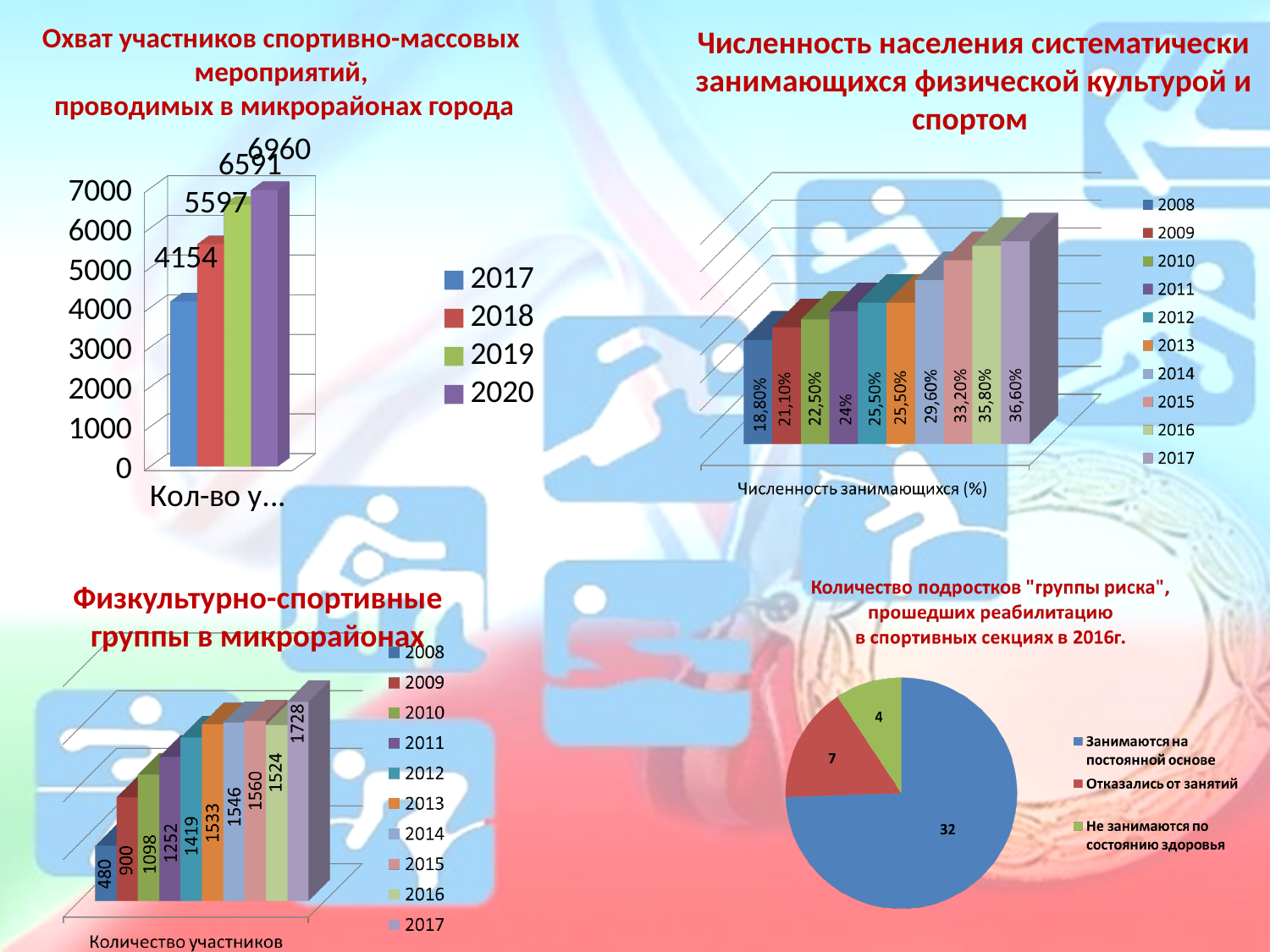
In the chart titled "Охват участников спортивно-массовых мероприятий, проводимых в микрорайонах города", how many series does the legend list? 4 In the chart titled "Охват участников спортивно-массовых мероприятий, проводимых в микрорайонах города", what is the value for 2018? 5597 In the chart titled "Охват участников спортивно-массовых мероприятий, проводимых в микрорайонах города", which year has the highest value? 2020 In the chart titled "Охват участников спортивно-массовых мероприятий, проводимых в микрорайонах города", what is the difference between the 2020 and 2017 values? 2806 In the chart titled "Численность населения систематически занимающихся физической культурой и спортом", which year has the lowest value? 2008 In the chart titled "Физкультурно-спортивные группы в микрорайонах", what is the difference between the 2017 and 2008 values? 1248 In the pie chart about подростков "группы риска", what is the value for "Отказались от занятий"? 7 In the chart titled "Численность населения систематически занимающихся физической культурой и спортом", do the values rise or fall from 2008 to 2017? rise In the chart titled "Численность населения систематически занимающихся физической культурой и спортом", what is the value for 2015? 33,20% In the chart titled "Физкультурно-спортивные группы в микрорайонах", which is larger, the value for 2015 or the value for 2016? 2015 In the chart titled "Физкультурно-спортивные группы в микрорайонах", what is the value for 2012? 1419 What kind of chart is the bottom-right chart about подростков "группы риска"? pie chart